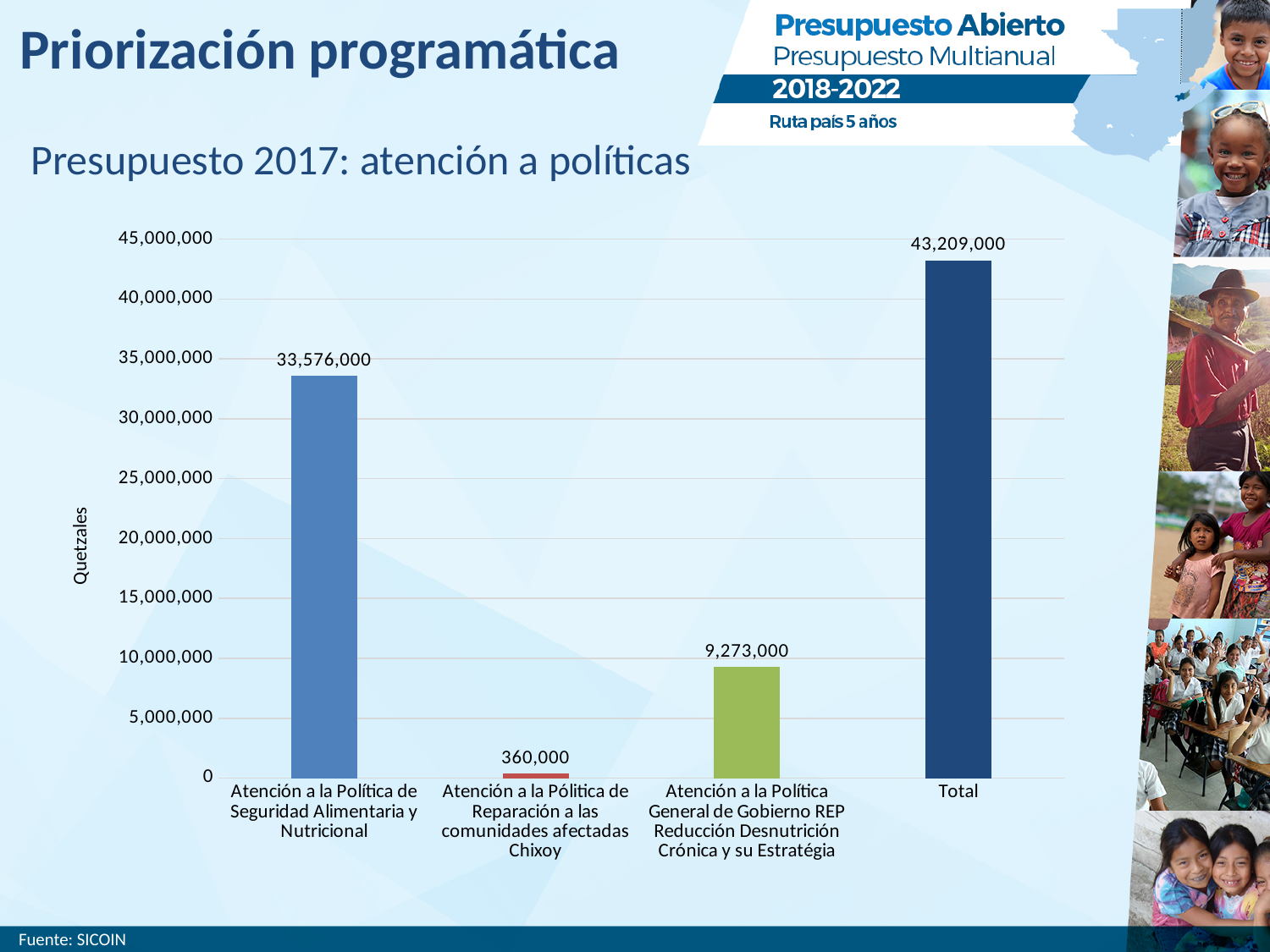
Excluding the Total bar, which category has the highest value? Atención a la Política de Seguridad Alimentaria y Nutricional What is the value for Atención a la Pólitica de Reparación a las comunidades afectadas Chixoy? 360,000 What is the value for Atención a la Política de Seguridad Alimentaria y Nutricional? 33,576,000 Which category has the lowest value? Atención a la Pólitica de Reparación a las comunidades afectadas Chixoy What is the value of the Total bar? 43,209,000 What is the value for Atención a la Política General de Gobierno REP Reducción Desnutrición Crónica y su Estratégia? 9,273,000 How many bars are shown in the chart? 4 What is the difference between the Total bar and the Seguridad Alimentaria y Nutricional bar? 9,633,000 What is the difference between the Seguridad Alimentaria y Nutricional value and the Reducción Desnutrición Crónica value? 24,303,000 What unit is shown on the vertical axis label of the chart? Quetzales What type of chart is shown on the slide? Bar chart Which is larger: the value for Reducción Desnutrición Crónica or the value for comunidades afectadas Chixoy? Reducción Desnutrición Crónica